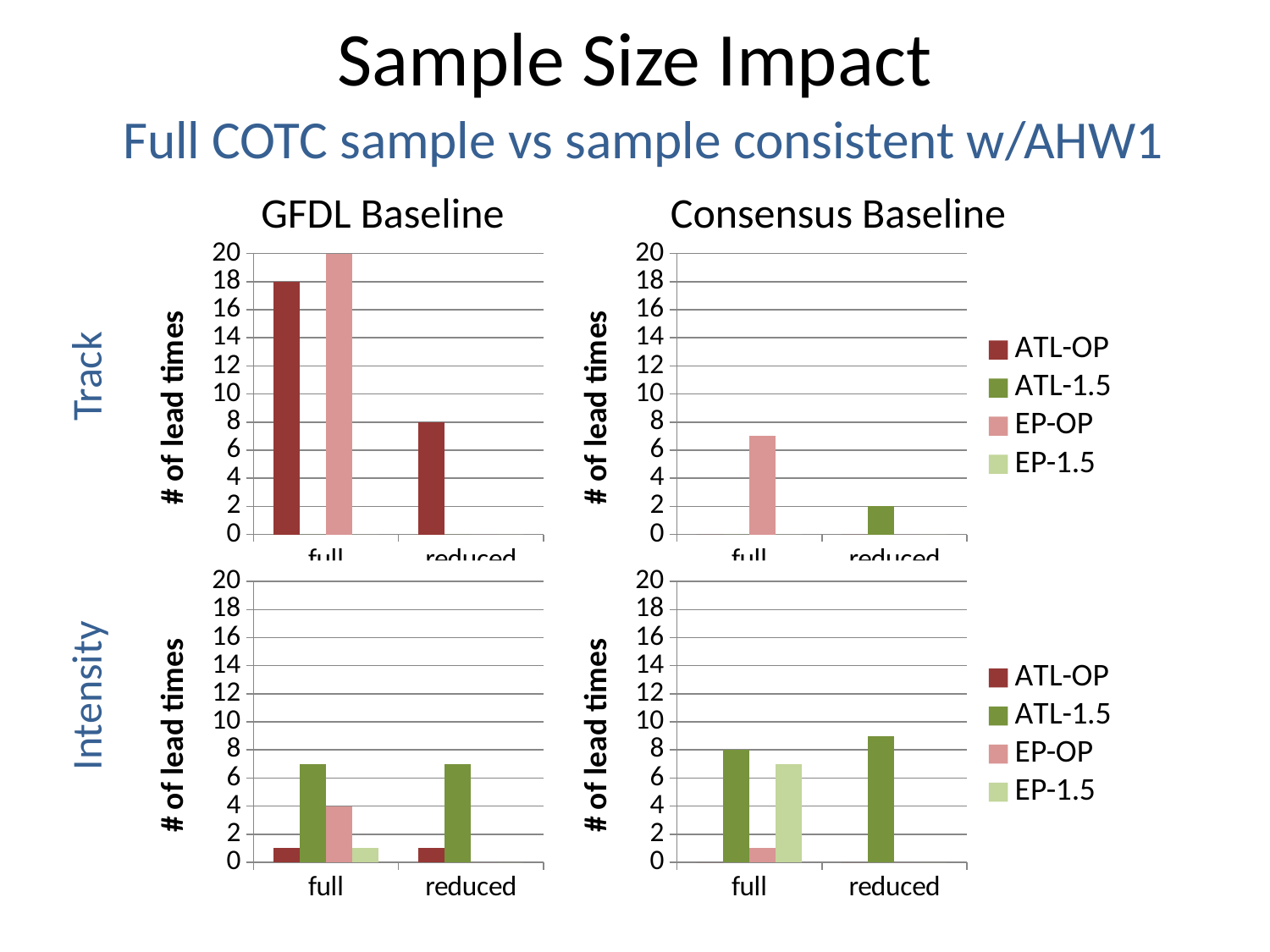
In the GFDL Baseline Track chart (top-left), what is the value of ATL-OP for the full sample? 18 In the Consensus Baseline Intensity chart (bottom-right), what is the value of ATL-1.5 for the full sample? 8 In the Consensus Baseline Track chart (top-right), is the value of EP-OP for the full sample greater or less than 6? greater In the GFDL Baseline Intensity chart (bottom-left), is the value of ATL-1.5 for the full sample greater or less than 6? greater In the GFDL Baseline Track chart (top-left), which series has the tallest bar? EP-OP In the Consensus Baseline Intensity chart (bottom-right), is the value of ATL-1.5 for the reduced sample greater or less than 8? greater In the Consensus Baseline Track chart (top-right), what is the value of ATL-1.5 for the reduced sample? 2 In the GFDL Baseline Track chart (top-left), what is the difference between the ATL-OP values for the full and reduced samples? 10 In the GFDL Baseline Track chart (top-left), what is the value of EP-OP for the full sample? 20 In the GFDL Baseline Track chart (top-left), what is the value of ATL-OP for the reduced sample? 8 In the GFDL Baseline Intensity chart (bottom-left), what is the value of EP-OP for the full sample? 4 How many series does the legend of the Track charts list? 4